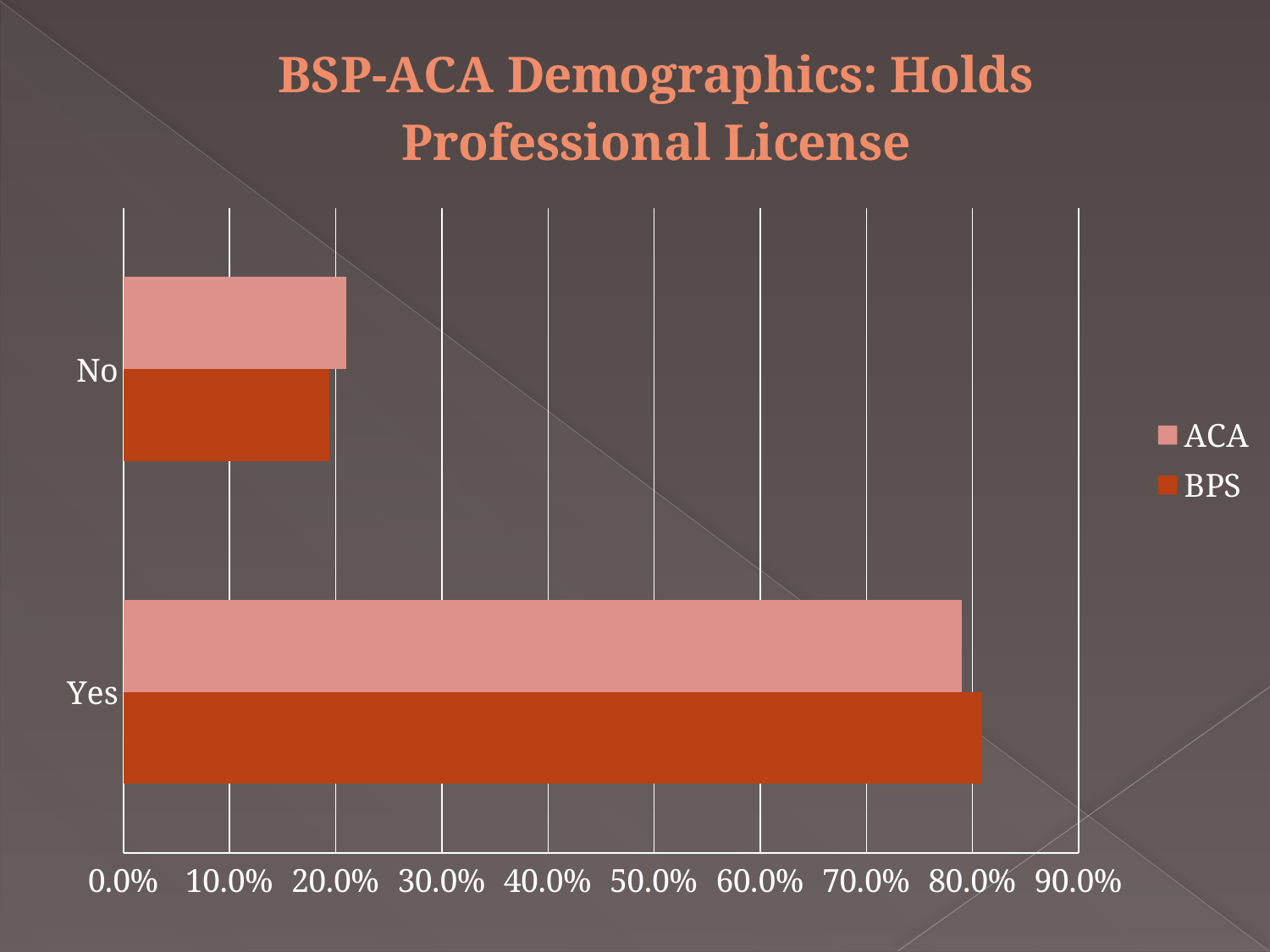
For the ACA series, which category has the highest value? Yes Which series are listed in the legend? ACA and BPS How many series does the legend list? 2 What kind of chart is shown on the slide? bar chart Is the BPS value for No greater or less than 30.0%? less What is the title of the chart? BSP-ACA Demographics: Holds Professional License For the ACA series, which category has the higher value, Yes or No? Yes How many categories are shown on the vertical axis? 2 Is the ACA value for No greater or less than 30.0%? less For the BPS series, which category has the lowest value? No Is the BPS value for Yes greater or less than 70.0%? greater